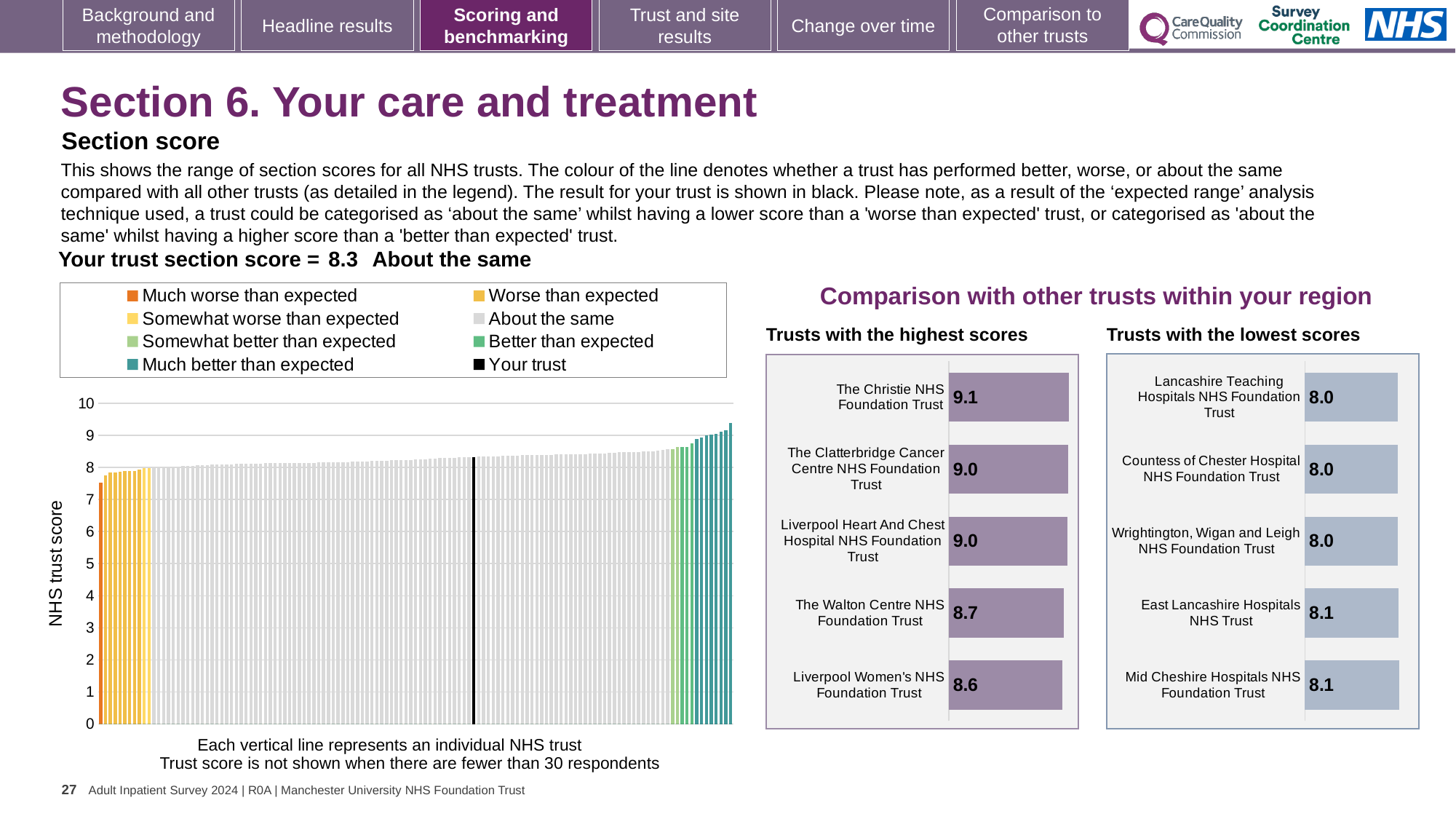
In the 'Trusts with the lowest scores' chart, which is larger: the score for Mid Cheshire Hospitals NHS Foundation Trust or for Lancashire Teaching Hospitals NHS Foundation Trust? Mid Cheshire Hospitals NHS Foundation Trust In the 'Trusts with the lowest scores' chart, what is the score for Countess of Chester Hospital NHS Foundation Trust? 8.0 In the 'Trusts with the highest scores' chart, what is the score for The Walton Centre NHS Foundation Trust? 8.7 In the 'Trusts with the highest scores' chart, which trust has the highest score? The Christie NHS Foundation Trust In the 'Trusts with the highest scores' chart, what is the score for The Christie NHS Foundation Trust? 9.1 What kind of chart is the large chart on the left showing all NHS trusts? bar chart In the 'Trusts with the highest scores' chart, which trust has the lowest score? Liverpool Women's NHS Foundation Trust In the 'Trusts with the lowest scores' chart, what is the score for East Lancashire Hospitals NHS Trust? 8.1 In the large chart on the left showing all NHS trusts, do the scores rise or fall from left to right? rise How many trusts are shown in the 'Trusts with the highest scores' chart? 5 In the 'Trusts with the highest scores' chart, what is the difference between the scores of The Christie NHS Foundation Trust and The Walton Centre NHS Foundation Trust? 0.4 How many entries does the legend of the large chart on the left list? 8